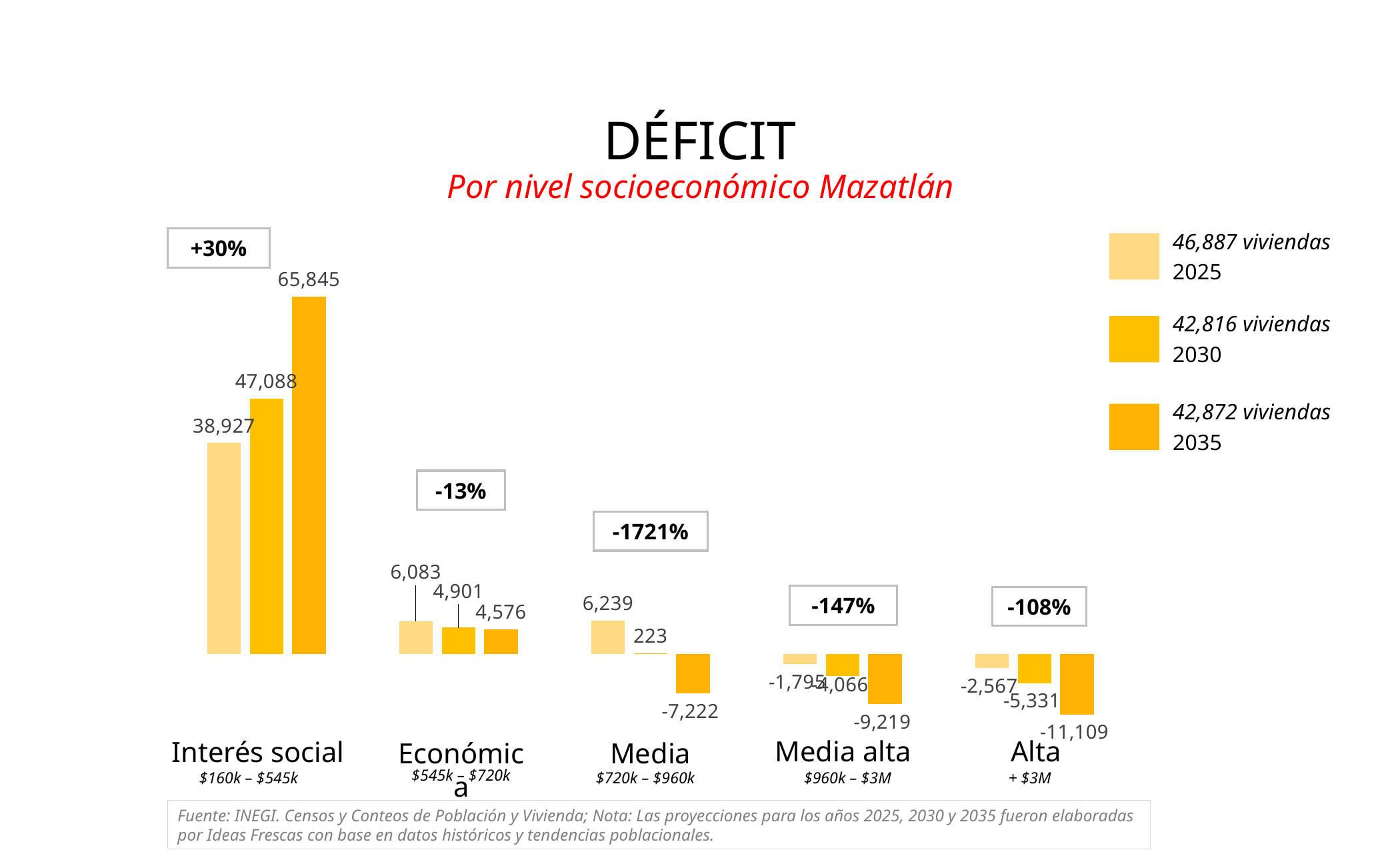
What is the 2025 value for Media? 6,239 Which is larger, the 2025 value for Económica or the 2025 value for Media? Media What is the 2030 value for Alta? -5,331 What is the difference between the 2035 and 2025 values for Interés social? 26,918 What is the difference between the 2025 and 2030 values for Económica? 1,182 Which category has the highest 2035 value? Interés social How many series does the legend list? 3 How many socioeconomic categories are shown on the x axis? 5 What kind of chart is shown on the slide? Bar chart What is the 2030 value for Media alta? -4,066 Which category has the lowest 2035 value? Alta What is the 2035 value for Interés social? 65,845